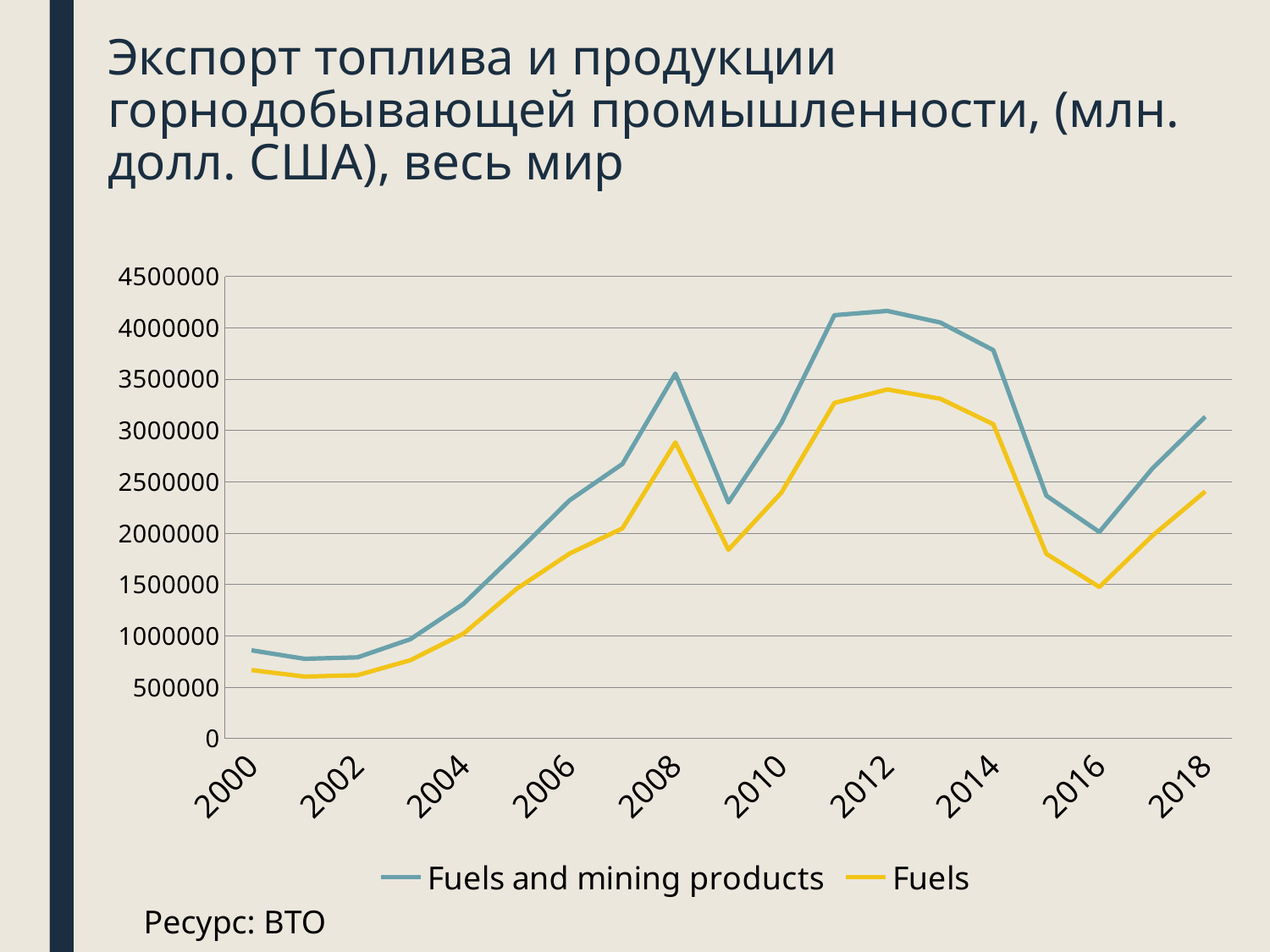
Is the value for Fuels in 2000 greater or less than 1000000? less Is the value for Fuels in 2016 greater or less than 2000000? less Do the values for Fuels and mining products rise or fall between 2014 and 2016? fall Which series has the higher value in 2010, Fuels and mining products or Fuels? Fuels and mining products What kind of chart is shown on the slide? line chart What are the two series named in the legend? Fuels and mining products; Fuels Which series is drawn in yellow? Fuels Is the value for Fuels and mining products in 2018 greater or less than 2500000? greater In which year does the Fuels series reach its highest value? 2012 How many series does the legend list? 2